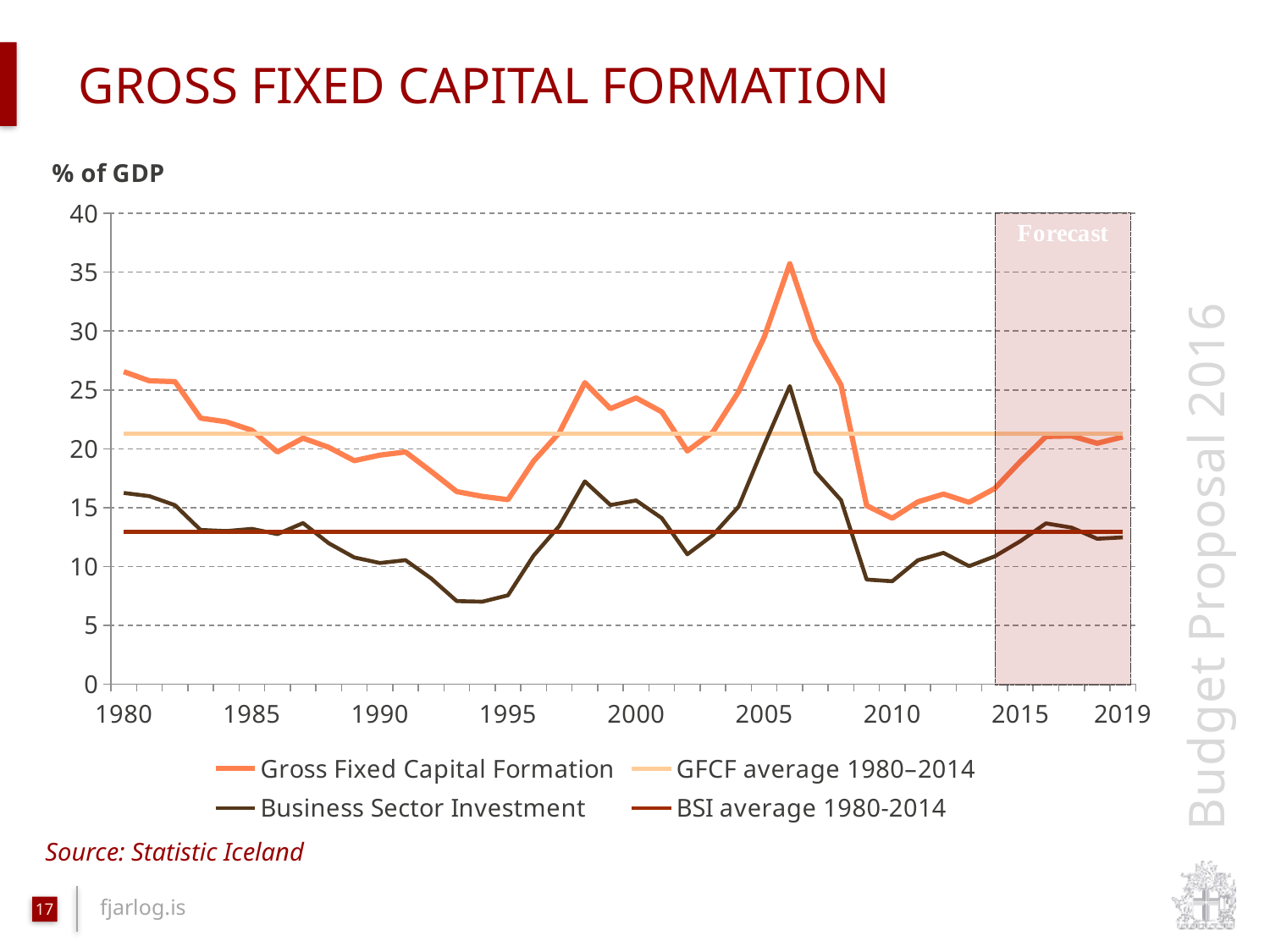
What is the label on the y axis of the chart? % of GDP Is the value for Business Sector Investment in 1993 greater or less than 10? less Is the GFCF average 1980–2014 line greater or less than 20? greater In which year does Gross Fixed Capital Formation reach its highest value? 2006 What kind of chart is shown on the slide? Line chart Does Gross Fixed Capital Formation rise or fall between 2006 and 2009? Fall How many series does the legend list? 4 Is the BSI average 1980-2014 line greater or less than 15? less In which year does Business Sector Investment reach its highest value? 2006 Which is larger, Gross Fixed Capital Formation in 1980 or in 2010? 1980 What label is shown on the shaded region at the right of the chart? Forecast